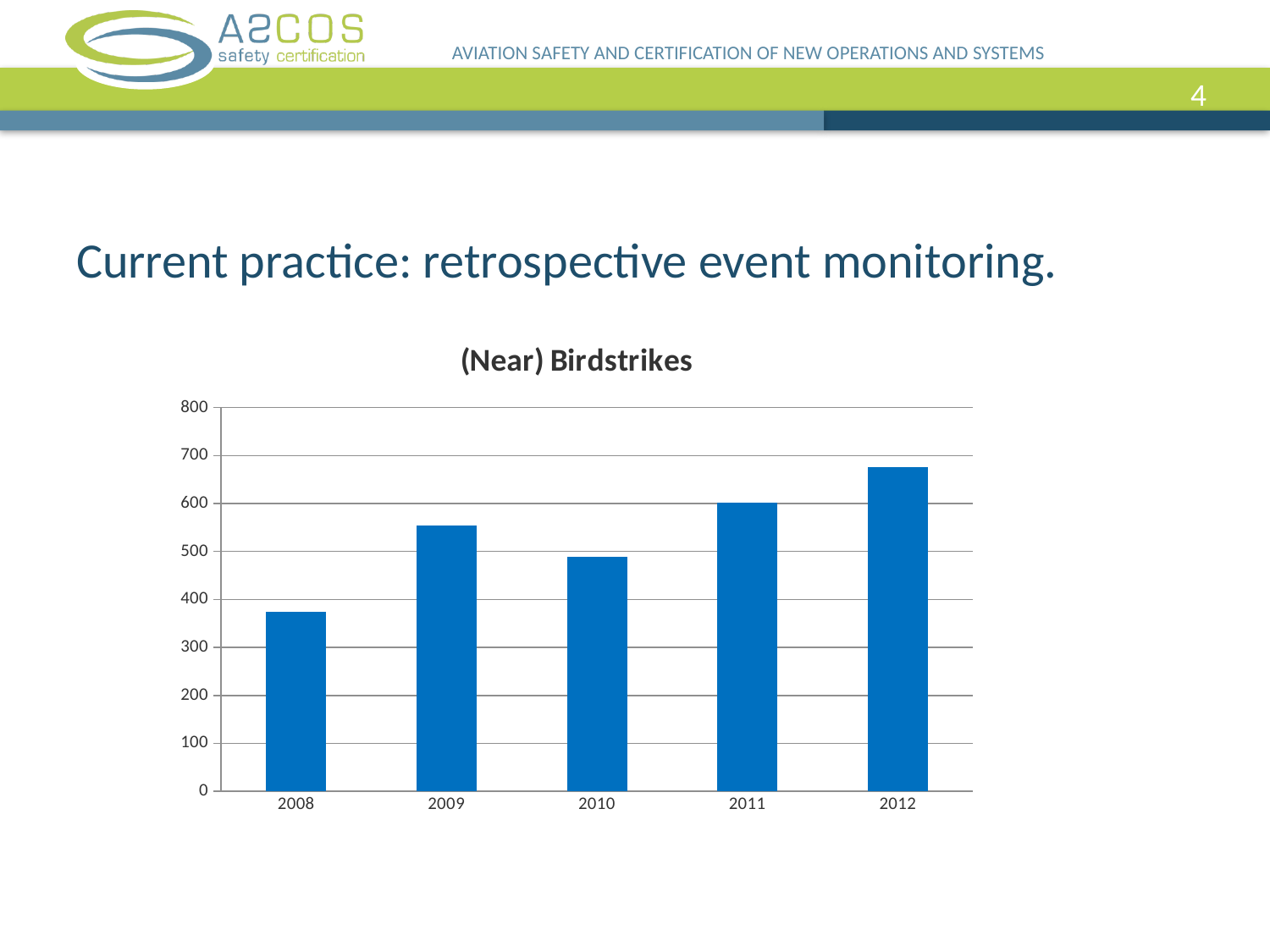
Is the value for 2010 greater or less than 400? greater Which year has the larger value, 2009 or 2010? 2009 Is the value for 2012 greater or less than 600? greater What kind of chart is shown on the slide? bar chart Is the value for 2008 greater or less than 400? less Which year has the highest number of (near) birdstrikes? 2012 What colour are the bars in the chart? blue What is the title of the chart? (Near) Birdstrikes Which year has the lowest number of (near) birdstrikes? 2008 How many years are shown on the x axis of the chart? 5 Which year has the larger value, 2011 or 2012? 2012